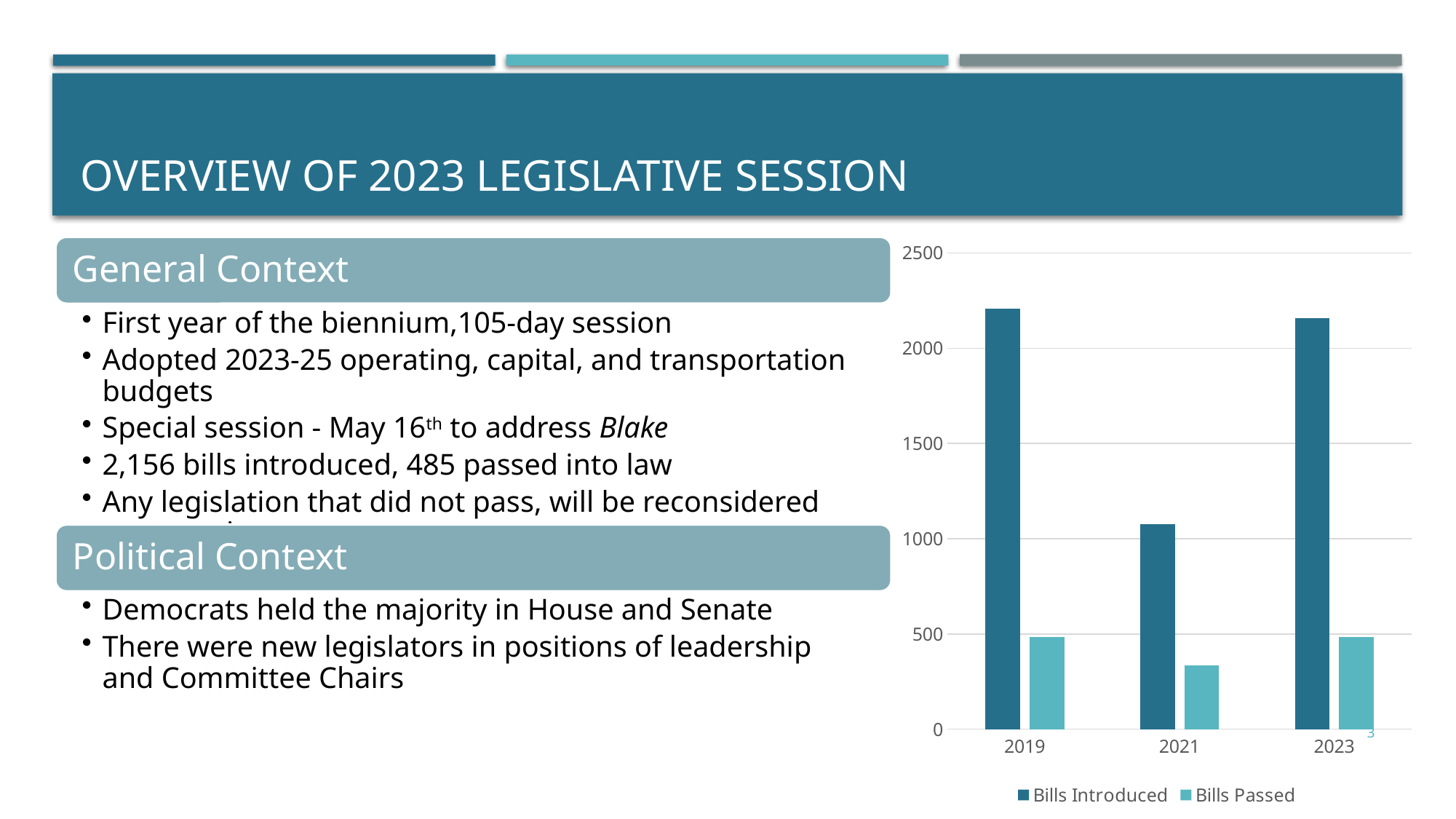
Which is larger: Bills Introduced in 2019 or Bills Introduced in 2021? Bills Introduced in 2019 Is the value for Bills Introduced in 2021 greater or less than 1500? less Is the value for Bills Passed in 2021 greater or less than 500? less In 2023, which series has the larger value: Bills Introduced or Bills Passed? Bills Introduced Is the value for Bills Introduced in 2023 greater or less than 2000? greater Which year has the lowest value for Bills Passed? 2021 What kind of chart is shown on the slide? bar chart How many series does the chart legend list? 2 What are the two series named in the chart legend? Bills Introduced and Bills Passed Which year has the lowest value for Bills Introduced? 2021 How many years are shown on the x axis of the chart? 3